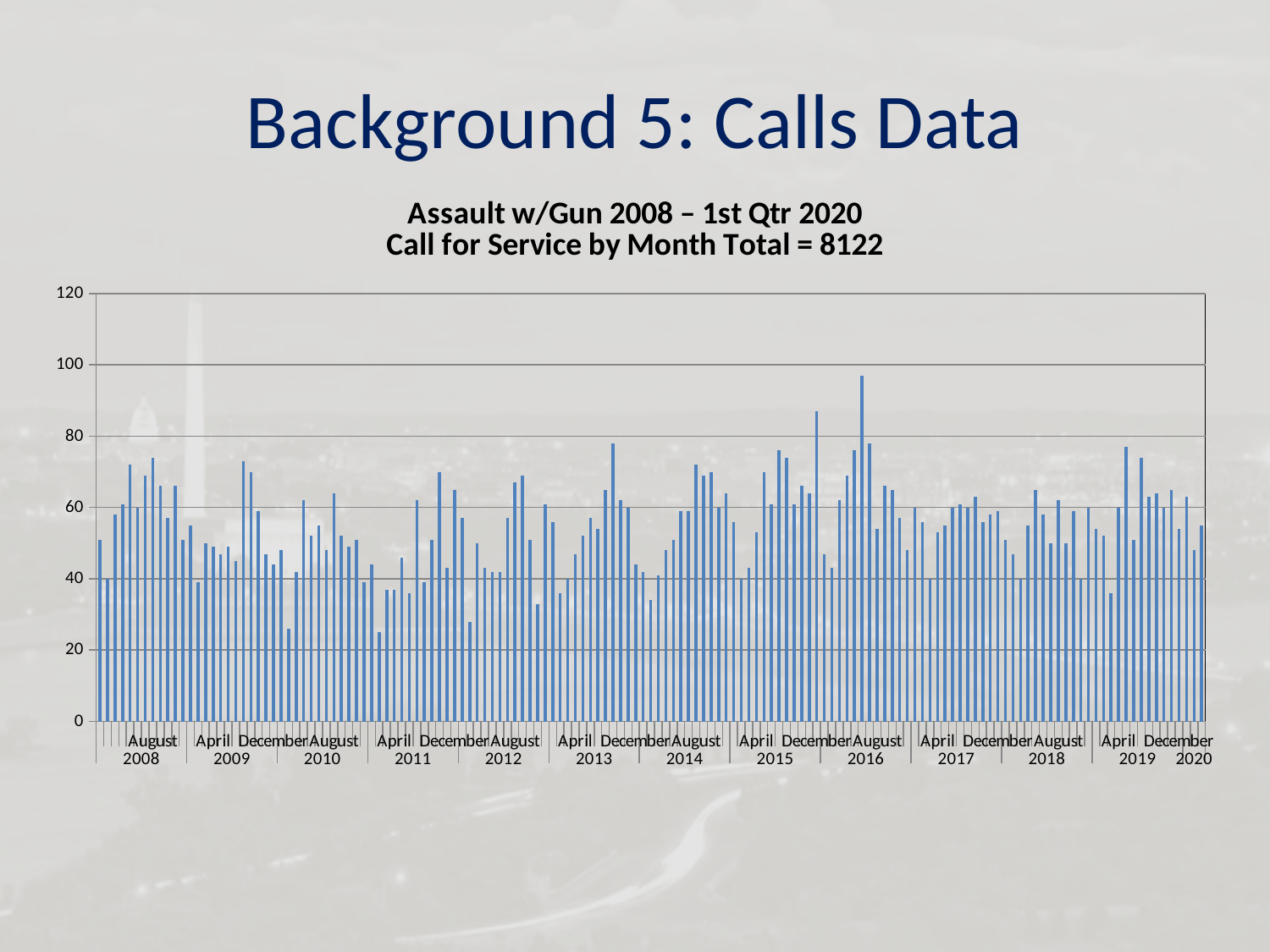
Is the tallest bar on the chart greater or less than 80? greater In which year does the tallest bar on the chart occur? 2016 According to the chart title, what is the total number of calls for service? 8122 Is the shortest bar on the chart greater or less than 40? less What is the highest value shown on the vertical axis? 120 What is the title of the chart? Assault w/Gun 2008 – 1st Qtr 2020 Call for Service by Month Total = 8122 Is the value for the first bar (January 2008) greater or less than 60? less What kind of chart is shown on the slide? bar chart How many data series does the chart plot? 1